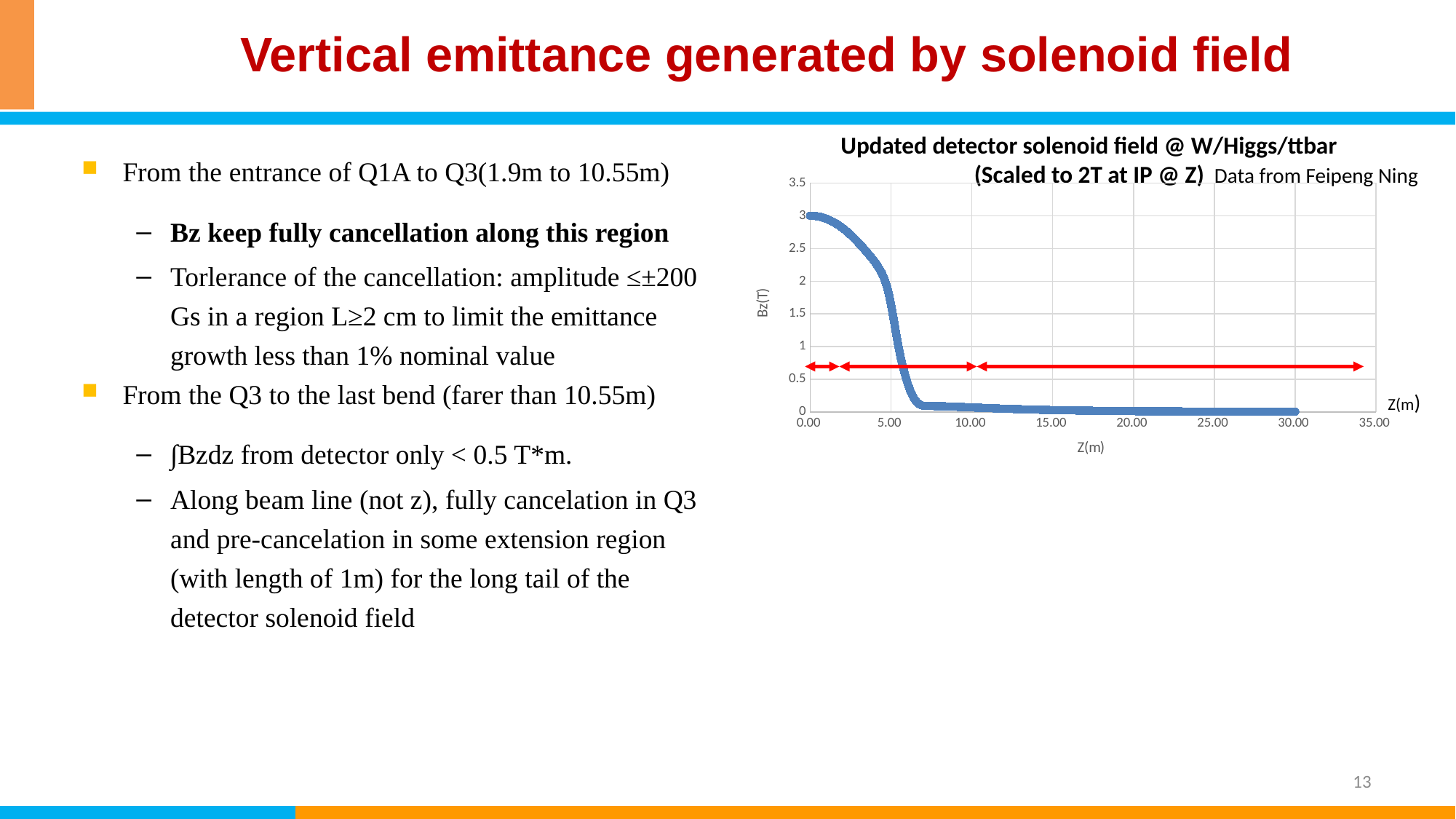
Which has the larger Bz value, Z = 0.00 m or Z = 30.00 m? Z = 0.00 m Is the value of Bz at Z = 20.00 m greater or less than 0.5? less What is the label of the vertical axis of the chart? Bz(T) What is the highest tick value shown on the vertical axis? 3.5 Is the value of Bz at Z = 10.00 m greater or less than 1? less Does Bz rise or fall as Z increases along the x axis? fall What is the title of the chart? Updated detector solenoid field @ W/Higgs/ttbar (Scaled to 2T at IP @ Z) Is the value of Bz at Z = 0.00 m greater or less than 2.5? greater What kind of chart is shown on the slide? scatter chart